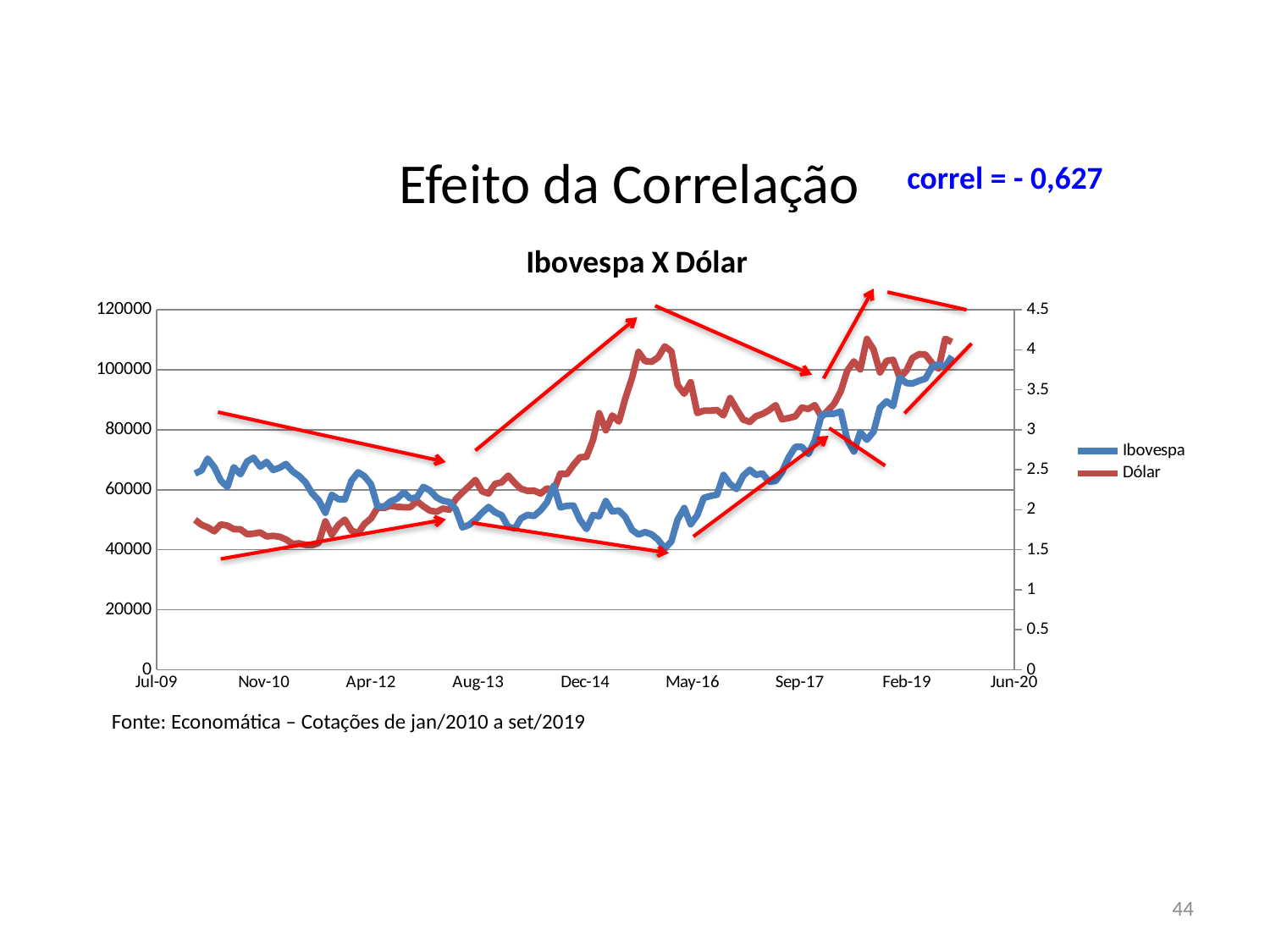
Does the Ibovespa series rise or fall between Nov-10 and May-16? fall What correlation value is printed on the slide next to the title? - 0,627 Is the Dólar value at its peak between Dec-14 and May-16 greater or less than 3.5? greater What kind of chart is shown on the slide? Line chart Is the Dólar value at the start of the series (early 2010) greater or less than 2? less Does the Dólar series overall rise or fall from 2010 to 2019? rise How many series does the legend of the 'Ibovespa X Dólar' chart list? 2 Is the Ibovespa value around May-16 greater or less than 60000? less What are the two series named in the legend of the chart? Ibovespa and Dólar